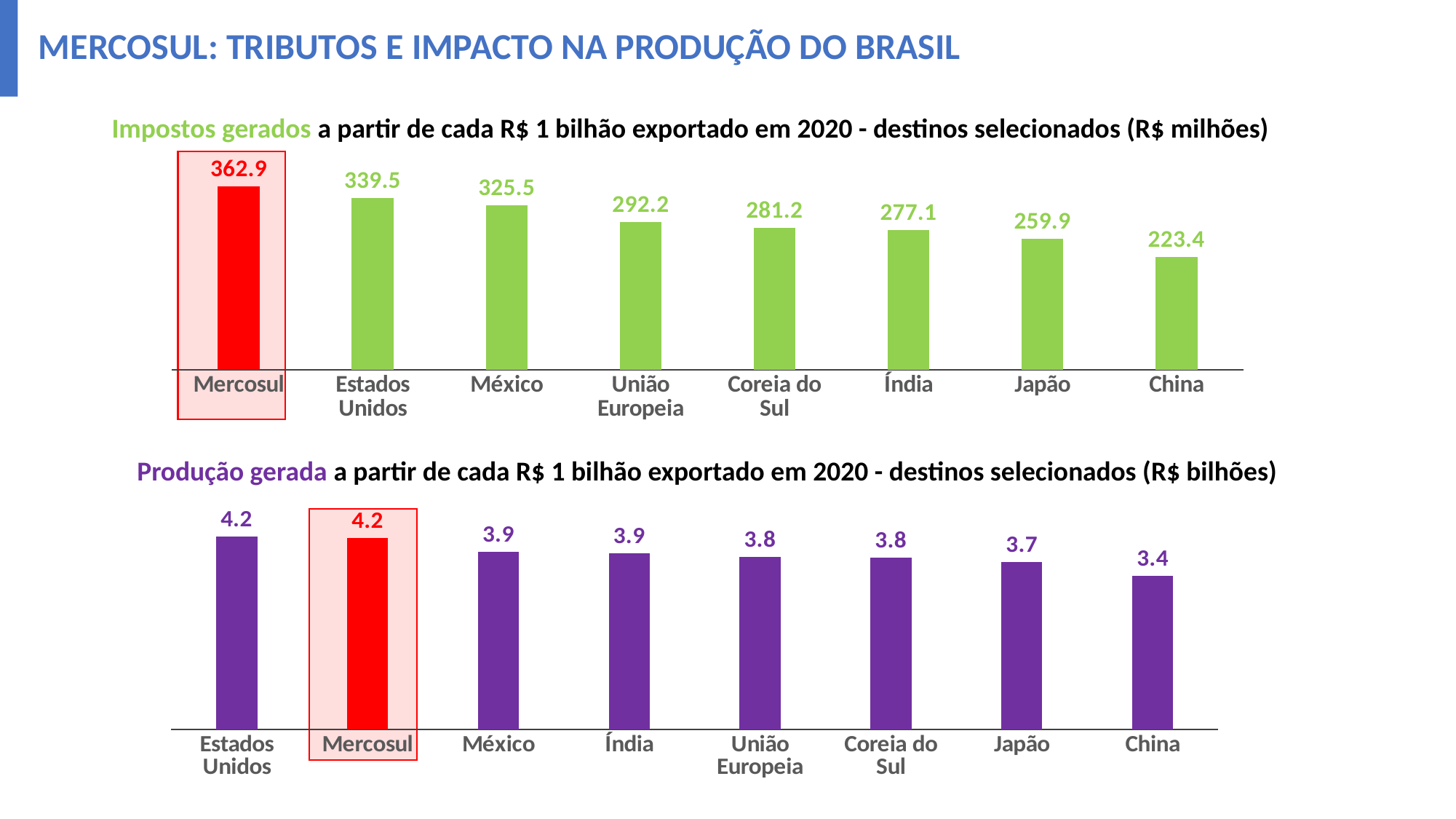
In the 'Produção gerada' chart (bottom), which is larger, the value for México or the value for China? México In the 'Produção gerada' chart (bottom), what is the value for Japão? 3.7 In the 'Impostos gerados' chart (top), which destination has the lowest value? China In the 'Produção gerada' chart (bottom), what is the difference between Estados Unidos and China? 0.8 In the 'Impostos gerados' chart (top), do the values rise or fall from left to right? fall In the 'Impostos gerados' chart (top), which destination has the highest value? Mercosul In the 'Produção gerada' chart (bottom), which destination has the lowest value? China In the 'Impostos gerados' chart (top), what is the value for China? 223.4 In the 'Impostos gerados' chart (top), how many destinations are shown? 8 What type of chart is the 'Produção gerada' chart (bottom)? bar chart In the 'Impostos gerados' chart (top), what is the difference between Mercosul and Estados Unidos? 23.4 In the 'Impostos gerados' chart (top), what is the value for Mercosul? 362.9